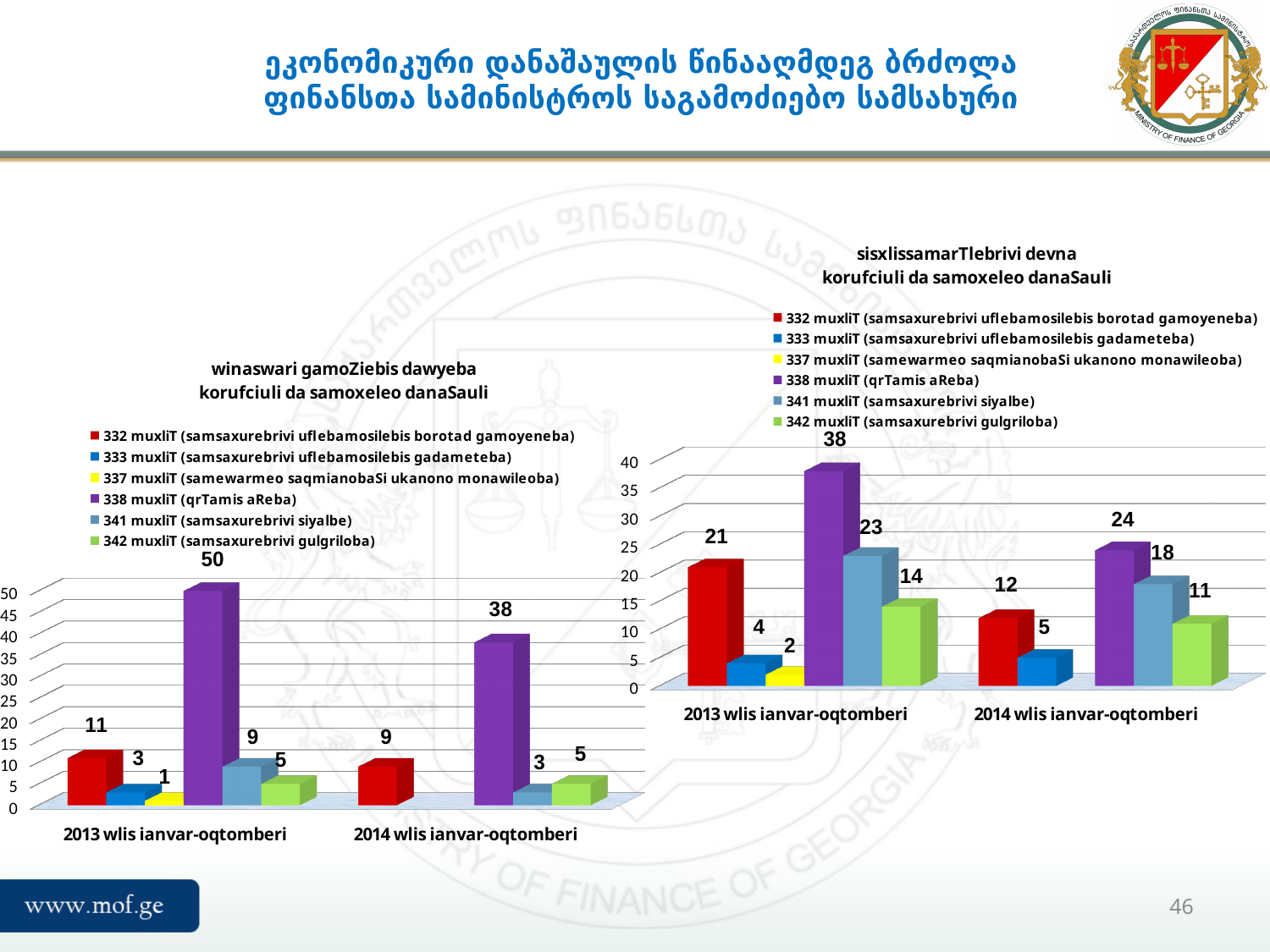
What kind of chart is the left chart (winaswari gamoZiebis dawyeba)? bar chart In the left chart (winaswari gamoZiebis dawyeba), what is the value for 338 muxliT (qrTamis aReba) in 2013 wlis ianvar-oqtomberi? 50 In the left chart (winaswari gamoZiebis dawyeba), what is the value for 332 muxliT in 2014 wlis ianvar-oqtomberi? 9 In the right chart (sisxlissamarTlebrivi devna), what is the difference between the 332 muxliT values for 2013 and 2014? 9 How many series does the legend of the right chart (sisxlissamarTlebrivi devna) list? 6 In the right chart (sisxlissamarTlebrivi devna), which is larger: 341 muxliT in 2013 or 338 muxliT in 2014? 338 muxliT in 2014 In the left chart (winaswari gamoZiebis dawyeba), what is the difference between the 338 muxliT values for 2013 and 2014? 12 In the right chart (sisxlissamarTlebrivi devna), what is the value for 341 muxliT (samsaxurebrivi siyalbe) in 2013 wlis ianvar-oqtomberi? 23 In the right chart (sisxlissamarTlebrivi devna), does the value for 338 muxliT rise or fall from 2013 to 2014? fall In the right chart (sisxlissamarTlebrivi devna), what is the value for 342 muxliT in 2014 wlis ianvar-oqtomberi? 11 In the left chart (winaswari gamoZiebis dawyeba), which series has the highest value in 2013 wlis ianvar-oqtomberi? 338 muxliT (qrTamis aReba) In the right chart (sisxlissamarTlebrivi devna), which series has the lowest value in 2013 wlis ianvar-oqtomberi? 337 muxliT (samewarmeo saqmianobaSi ukanono monawileoba)